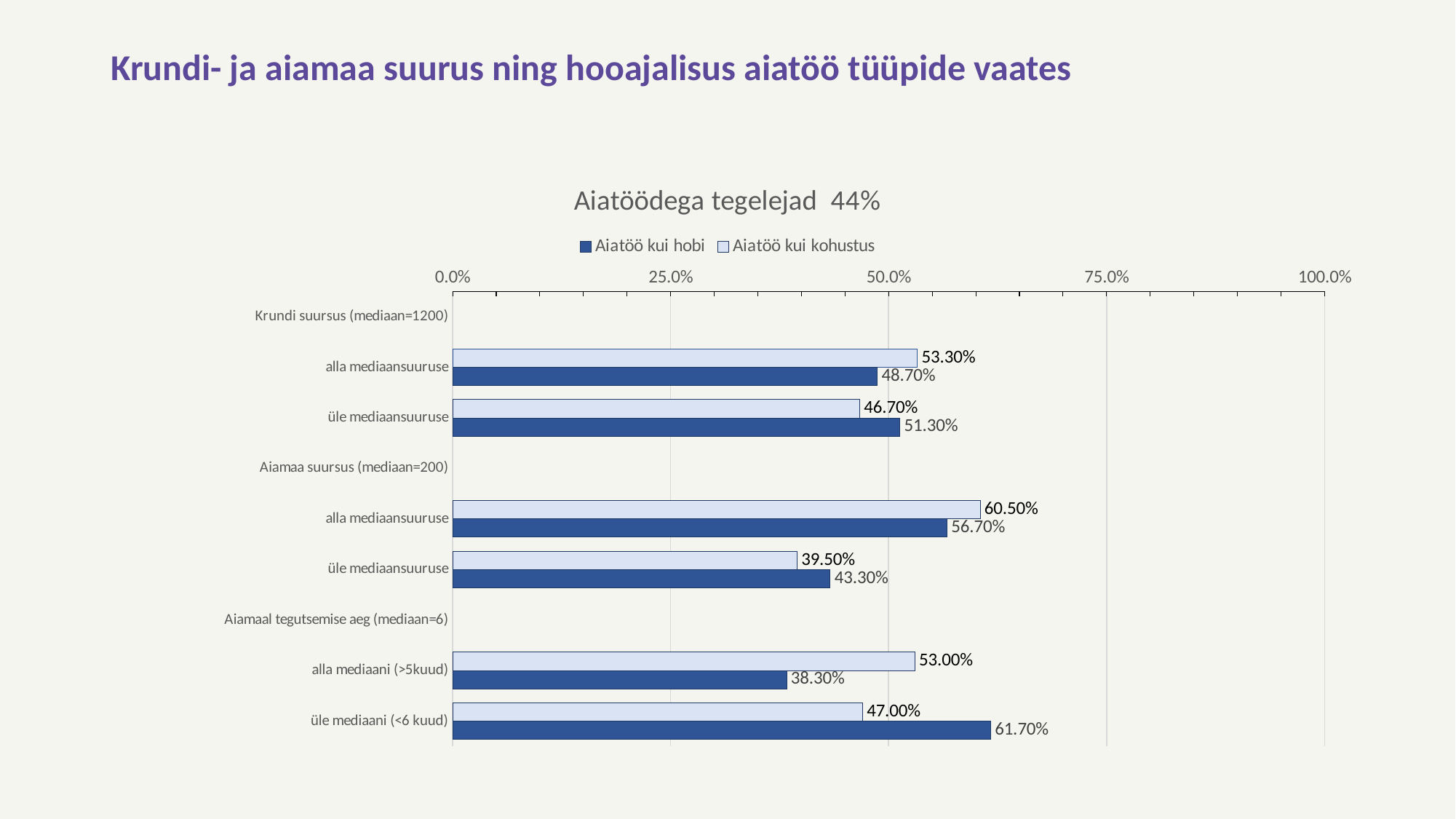
What is the value for 'Aiatöö kui hobi' for 'üle mediaani (<6 kuud)' under 'Aiamaal tegutsemise aeg'? 61.70% Which category has the lowest value for 'Aiatöö kui kohustus'? üle mediaansuuruse (Aiamaa suursus) For 'alla mediaansuuruse' under 'Krundi suursus (mediaan=1200)', which series has the larger value? Aiatöö kui kohustus What is the value for 'Aiatöö kui kohustus' for 'alla mediaansuuruse' under 'Aiamaa suursus (mediaan=200)'? 60.50% What is the difference between 'Aiatöö kui hobi' and 'Aiatöö kui kohustus' for 'alla mediaani (>5kuud)'? 14.70% Which category has the highest value for 'Aiatöö kui hobi'? üle mediaani (<6 kuud) What is the title of the chart? Aiatöödega tegelejad 44% What is the value for 'Aiatöö kui hobi' for 'alla mediaani (>5kuud)' under 'Aiamaal tegutsemise aeg'? 38.30% What is the value for 'Aiatöö kui kohustus' for 'üle mediaansuuruse' under 'Krundi suursus (mediaan=1200)'? 46.70% How many series does the legend list? 2 What kind of chart is shown on the slide? bar chart Is the value for 'Aiatöö kui hobi' for 'üle mediaansuuruse' under 'Aiamaa suursus' greater or less than 50.0%? less